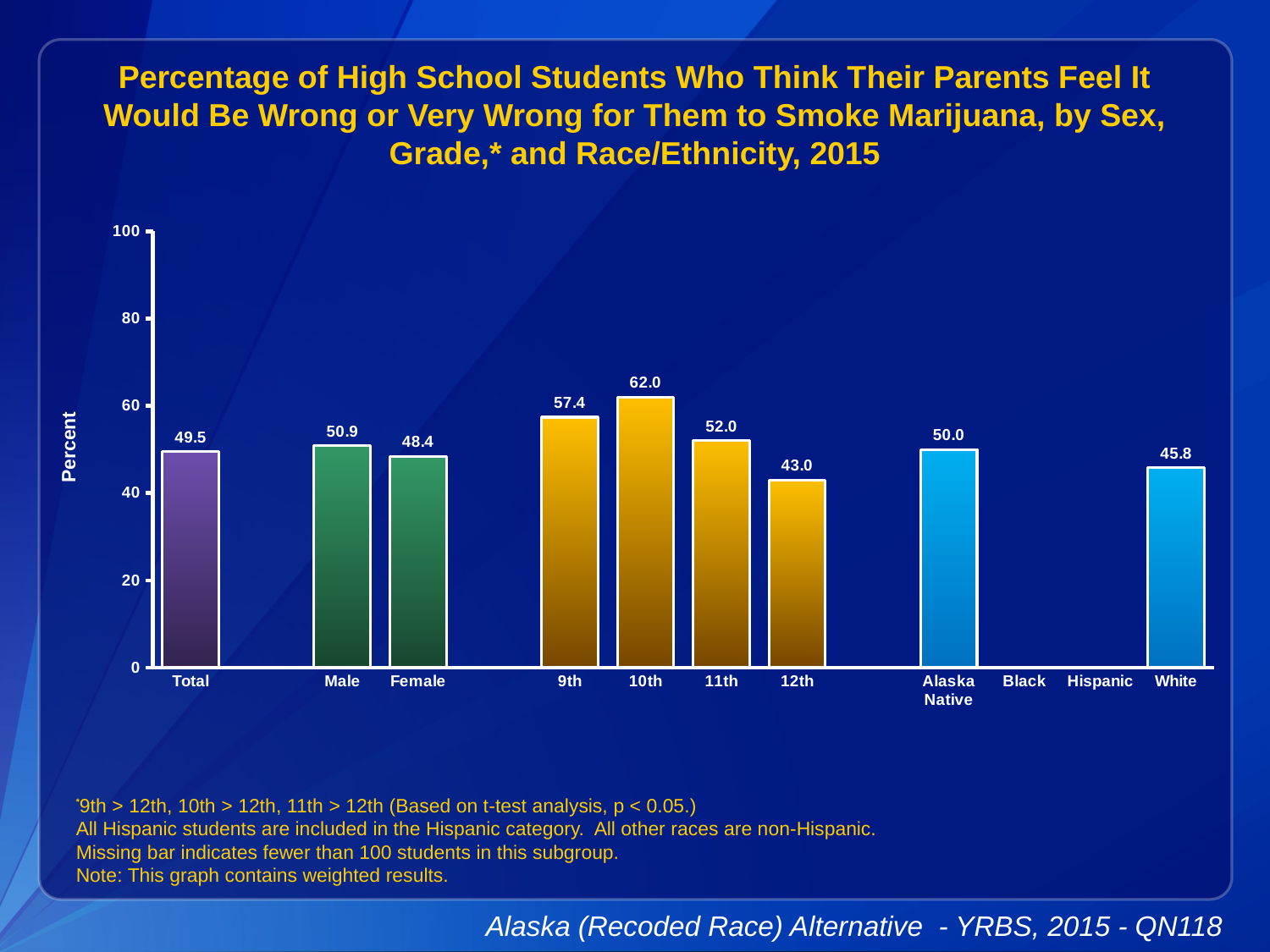
What is the difference between the Male and Female values? 2.5 What is the value for 10th grade? 62.0 What is the difference between the 9th and 12th grade values? 14.4 What is the value for Total? 49.5 What is the label on the y axis? Percent Is the value for 11th grade greater or less than 40? greater What is the value for Alaska Native? 50.0 Which is larger, the value for Alaska Native or the value for White? Alaska Native What kind of chart is shown? bar chart How many categories have a bar plotted? 9 Which category with a bar has the lowest value? 12th Which category has the highest value? 10th